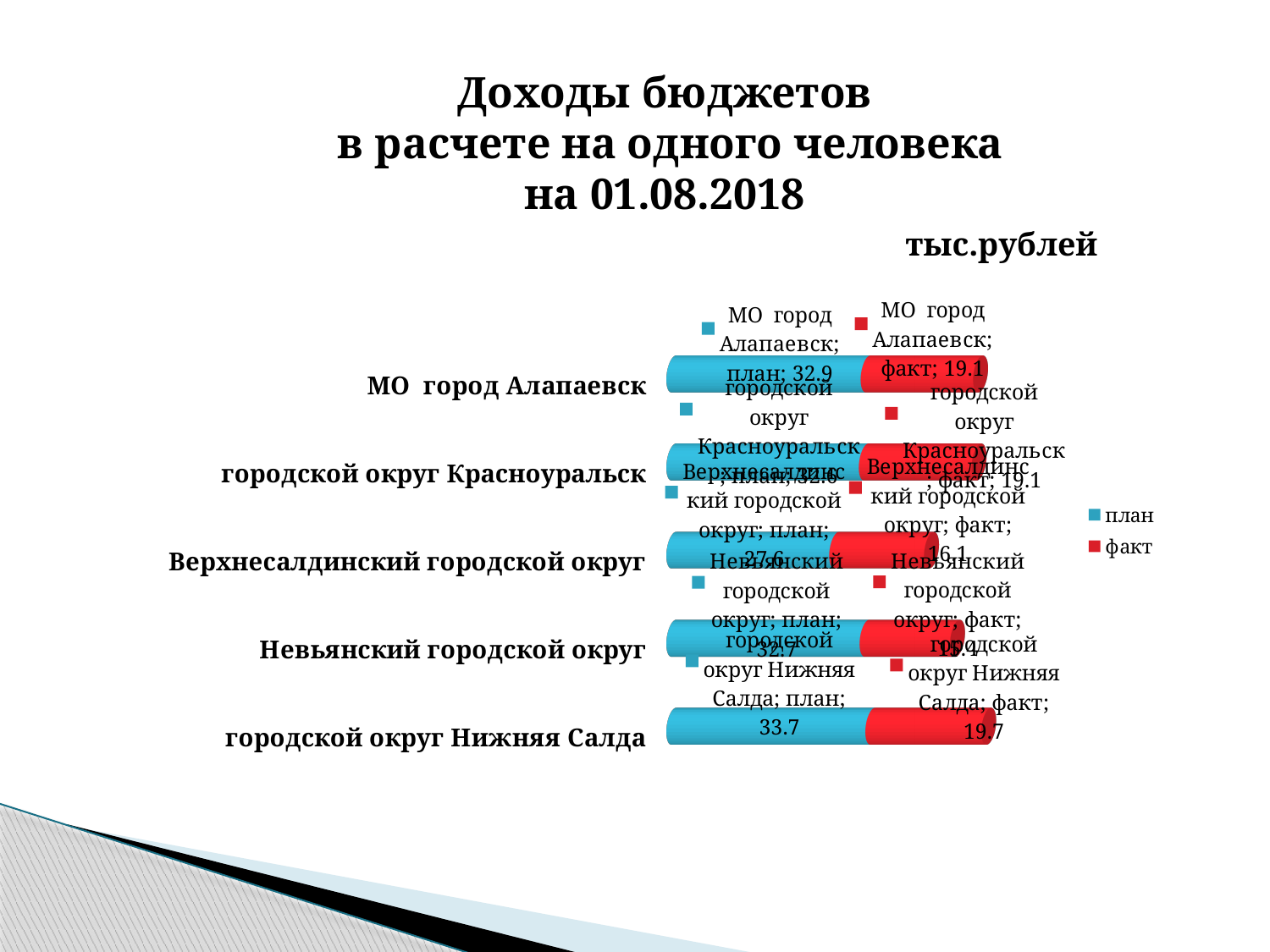
Which municipality has the lowest план value? Верхнесалдинский городской округ What is the факт value for Верхнесалдинский городской округ? 16.1 Which colour represents the факт series in the legend? red What is the факт value for МО город Алапаевск? 19.1 What is the difference between the план and факт values for МО город Алапаевск? 13.8 How many municipalities (categories) are shown in the chart? 5 What kind of chart is shown on the slide? bar chart What is the план value for МО город Алапаевск? 32.9 What is the план value for Верхнесалдинский городской округ? 27.6 What is the план value for городской округ Нижняя Салда? 33.7 How many series does the legend list? 2 What is the факт value for городской округ Нижняя Салда? 19.7